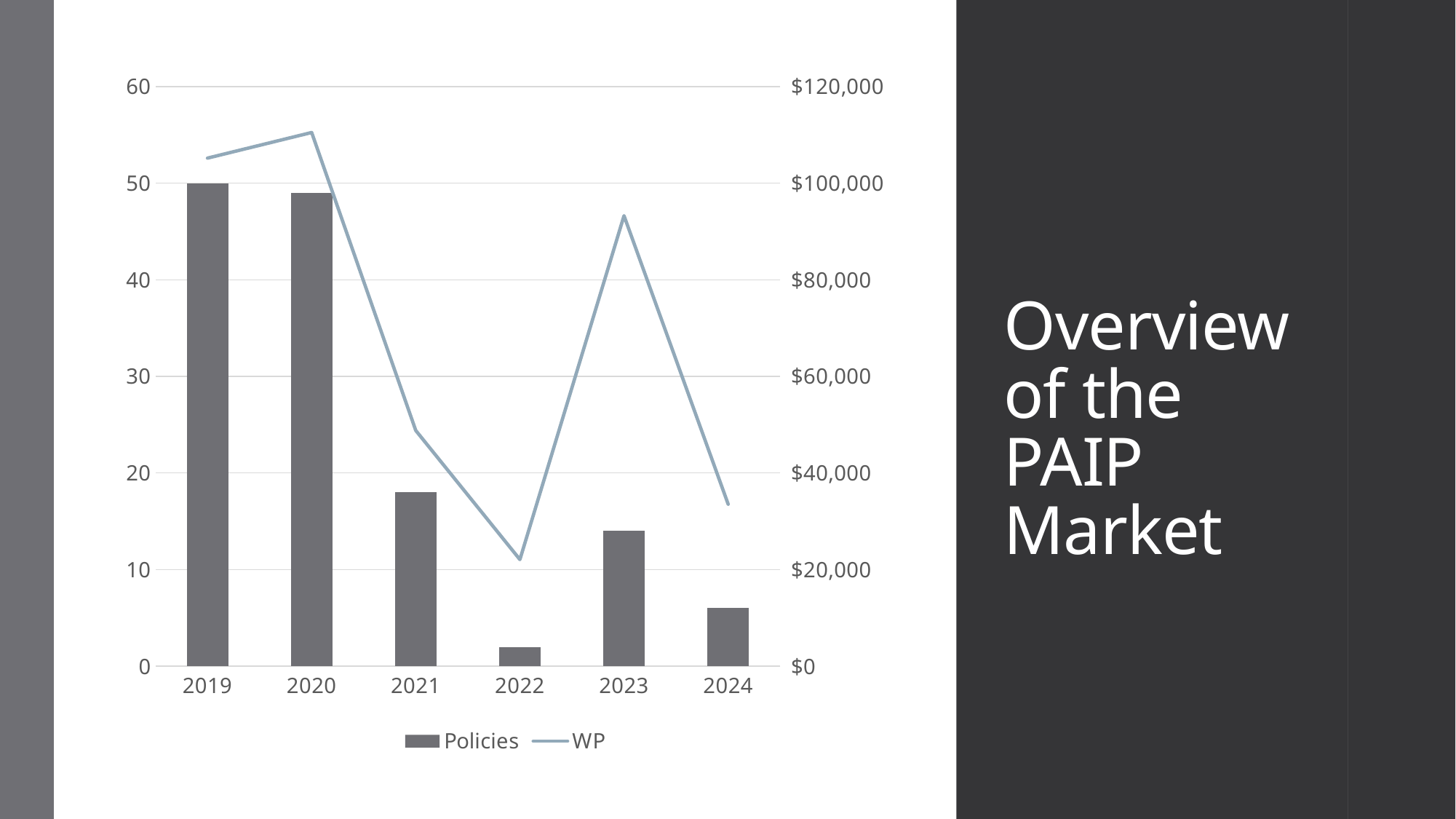
Which year has the highest WP value? 2020 What is the value of Policies for 2019? 50 Which year has the lowest number of Policies? 2022 What kind of chart is shown on the slide? A combination bar and line chart Is the WP value for 2024 greater or less than $40,000? less Is the Policies value for 2021 greater or less than 20? less Do the Policies values rise or fall from 2019 to 2022? fall Which year has more Policies, 2021 or 2023? 2021 Is the WP value for 2023 greater or less than $80,000? greater How many series does the legend list? 2 How many years are shown on the x axis? 6 Which year has the lowest WP value? 2022